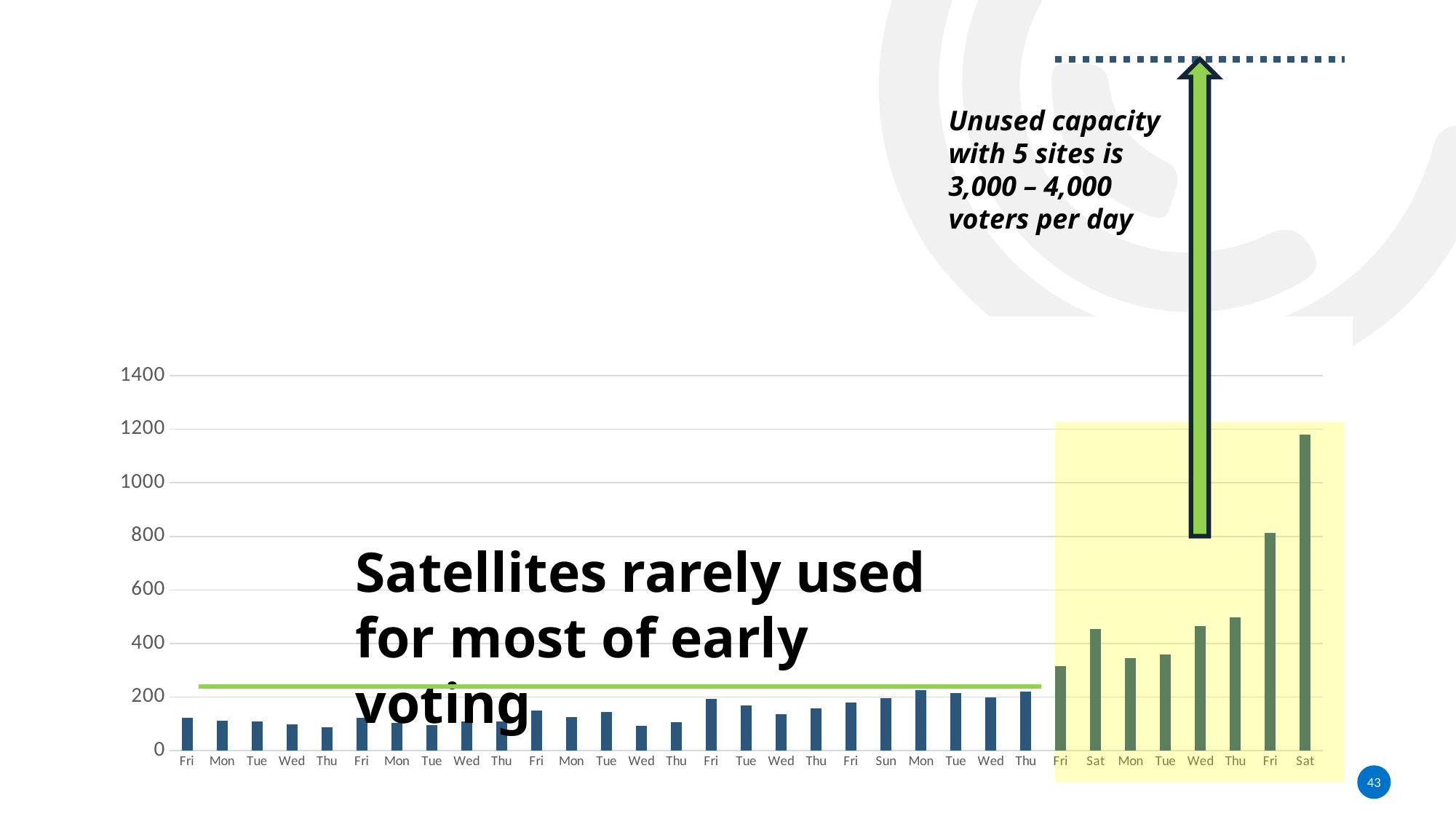
Is the value for the final Sat bar greater or less than 1000? greater How many bars are inside the yellow highlighted area? 8 What kind of chart is shown on the slide? bar chart Do the bars inside the yellow highlighted area generally rise or fall from left to right? rise Which is larger, the last Fri bar or the last Sat bar? the last Sat bar What is the highest value shown on the vertical axis? 1400 According to the annotation, what is the unused capacity with 5 sites per day? 3,000 – 4,000 voters per day Is the value for the Wed bar inside the yellow highlighted area greater or less than 600? less Which day has the highest bar on the chart? Sat (the last bar) Which is larger, the first Fri bar or the last Sat bar? the last Sat bar Is the value for the Sun bar greater or less than 400? less